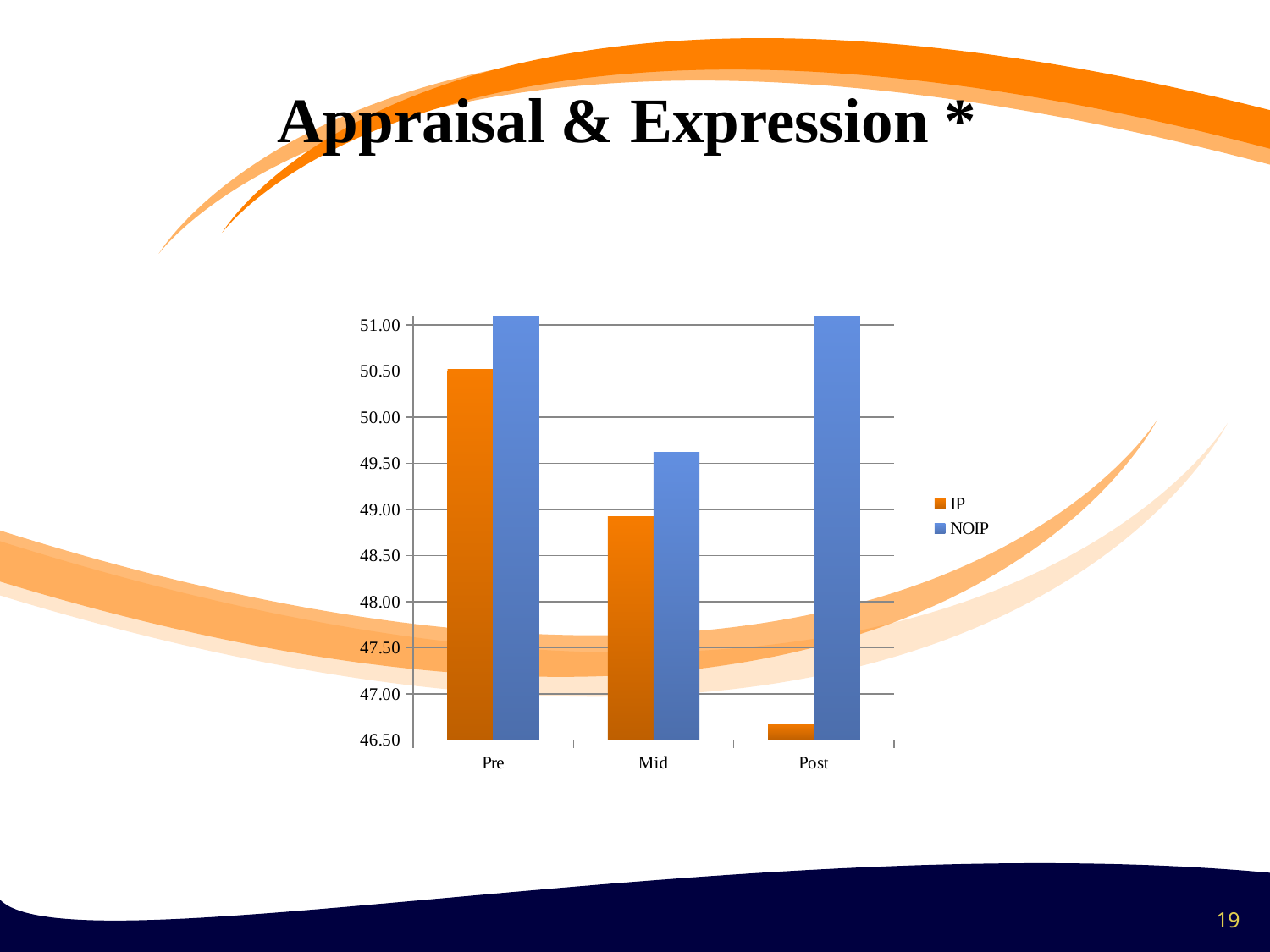
Is the value for NOIP at Mid greater or less than 50.00? less Which series is shown in orange in the legend? IP How many categories are shown on the x axis? 3 What kind of chart is shown on the slide? bar chart Is the value for IP at Post greater or less than 47.00? less Which category has the lowest value for the NOIP series? Mid Which category has the highest value for the IP series? Pre Do the IP values rise or fall from Pre to Post? fall How many series does the legend list? 2 What is the title of the slide containing the chart? Appraisal & Expression * At Post, which series has the larger value, IP or NOIP? NOIP Which category has the lowest value for the IP series? Post